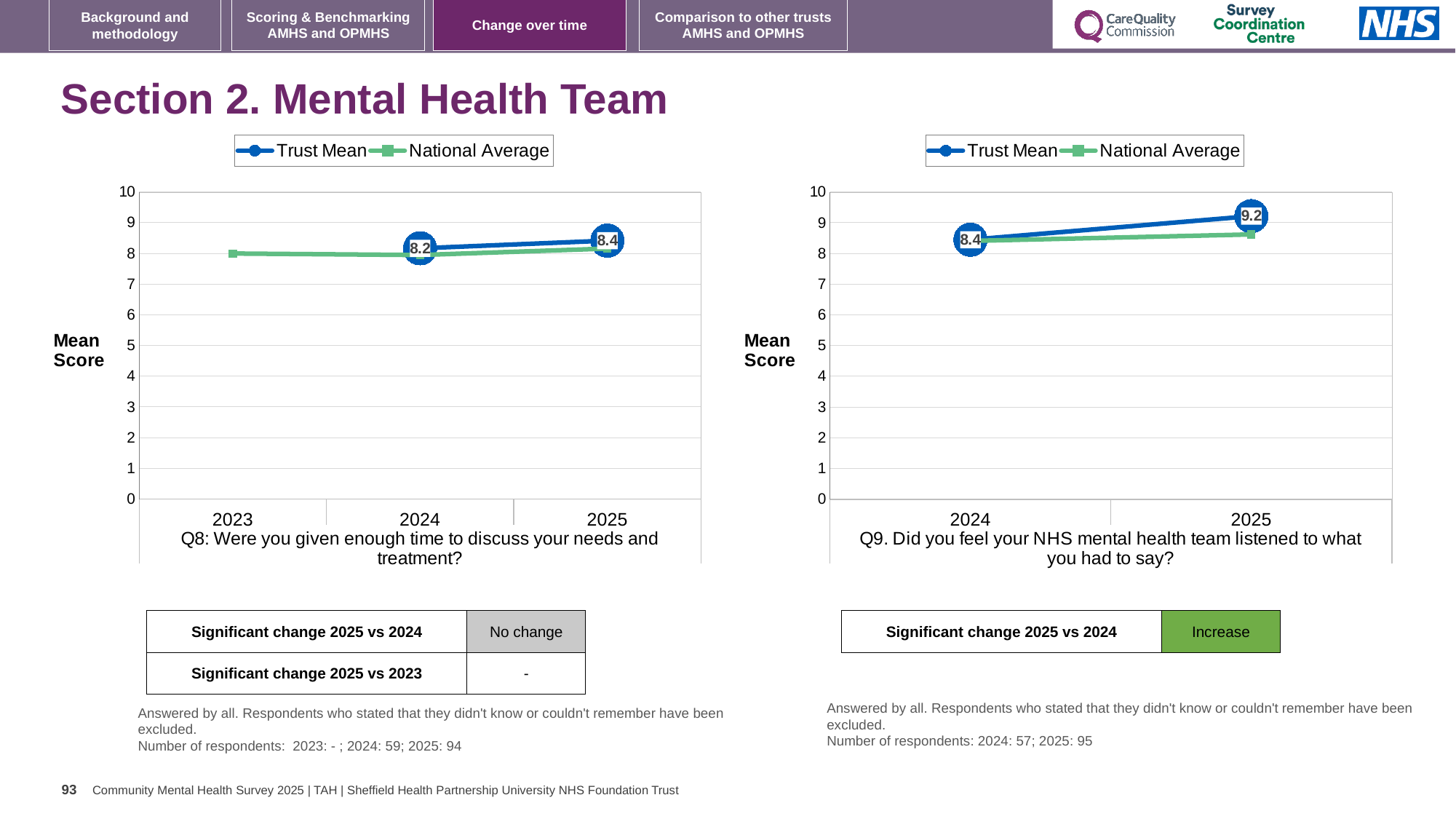
In the Q8 chart on the left, what is the difference between the Trust Mean in 2025 and in 2024? 0.2 In the Q8 chart on the left, what is the Trust Mean for 2025? 8.4 In the Q9 chart on the right, what is the Trust Mean for 2025? 9.2 What kind of chart is the Q8 chart on the left? line chart How many years are shown on the x axis of the Q8 chart on the left? 3 How many series does the legend of the Q9 chart on the right list? 2 In the Q8 chart on the left, what is the Trust Mean for 2024? 8.2 In the Q9 chart on the right, which series has the higher value in 2025, Trust Mean or National Average? Trust Mean In the Q9 chart on the right, is the National Average for 2025 greater or less than 9? less In the Q9 chart on the right, by how much did the Trust Mean change from 2024 to 2025? 0.8 In the Q9 chart on the right, what is the Trust Mean for 2024? 8.4 In the Q9 chart on the right, does the Trust Mean rise or fall from 2024 to 2025? rise